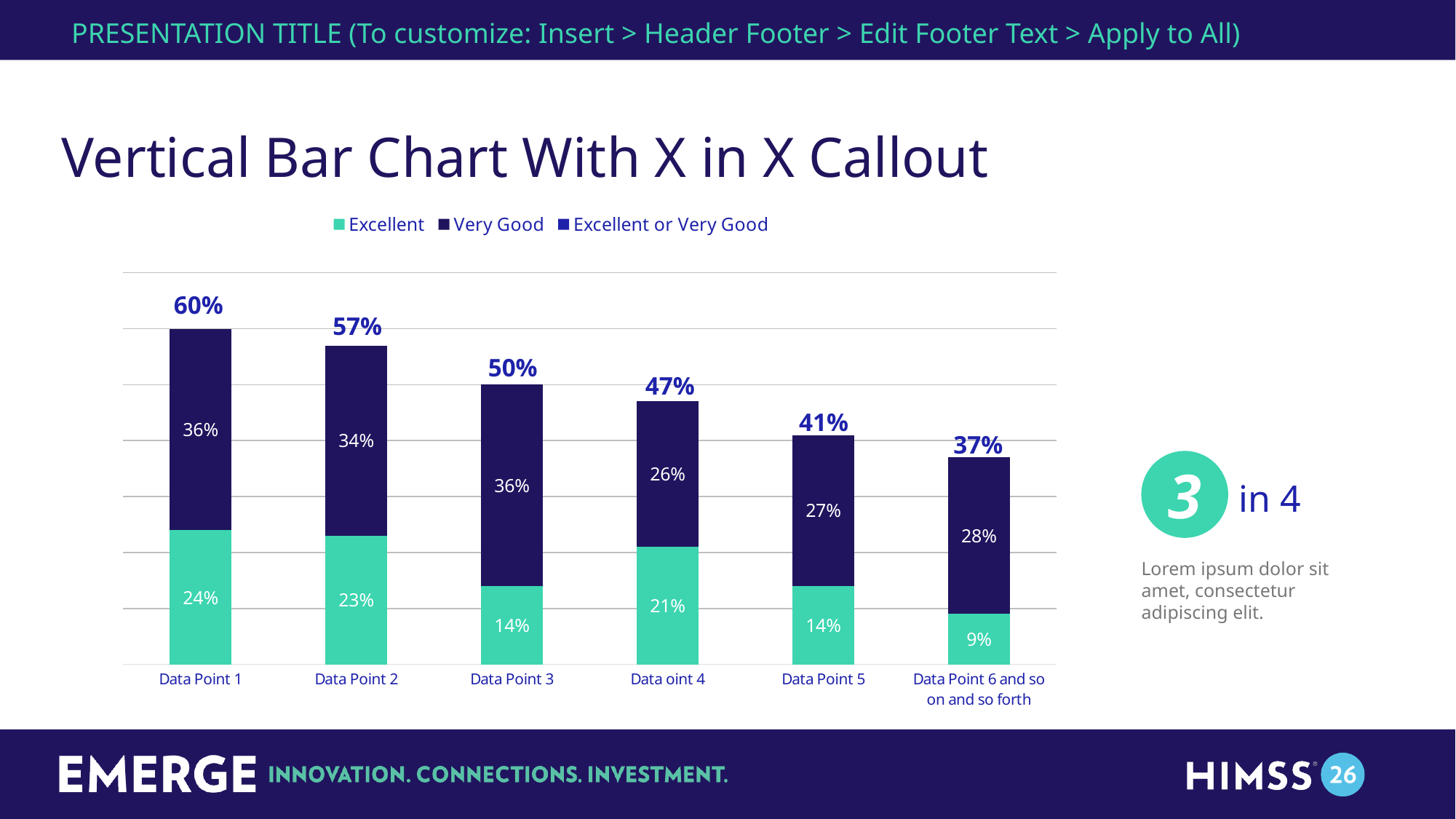
What number is shown in the green circle callout to the right of the chart? 3 What is the Very Good value for Data Point 3? 36% How many categories are shown on the x axis? 6 Do the Excellent or Very Good totals rise or fall from Data Point 1 to Data Point 6? Fall What is the Excellent value for Data Point 1? 24% What is the difference between the Excellent or Very Good totals for Data Point 1 and Data Point 2? 3% How many series does the legend list? 3 What kind of chart is shown on the slide? Stacked bar chart Which is larger, the Very Good value for Data Point 2 or the Very Good value for Data Point 5? Data Point 2 What is the Excellent or Very Good total shown above the bar for Data Point 5? 41% Which category has the lowest Excellent value? Data Point 6 and so on and so forth Which category has the highest Excellent or Very Good total? Data Point 1